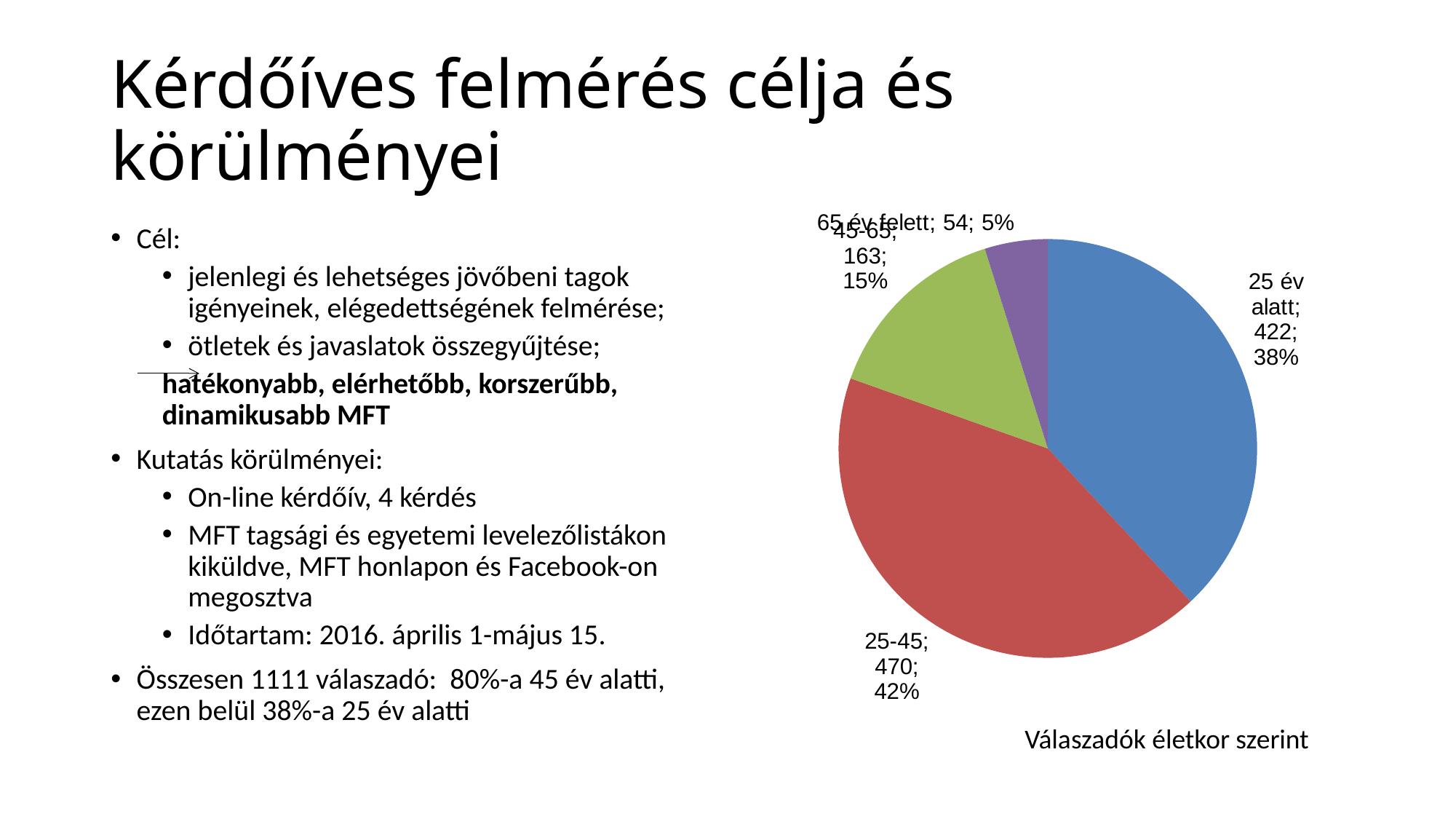
How many slices does the pie chart have? 4 Which age group has the smallest slice? 65 év felett What is the value for the '25 év alatt' slice? 422 Which age group has the largest slice? 25-45 What is the difference between the values for '25-45' and '25 év alatt'? 48 What is the value for the '45-65' slice? 163 What is the value for the '65 év felett' slice? 54 What is the title of the pie chart? Válaszadók életkor szerint What is the value for the '25-45' slice? 470 What share of the pie does the '25 év alatt' slice represent? 38% What kind of chart is shown on the slide? pie chart What share of the pie does the '45-65' slice represent? 15%